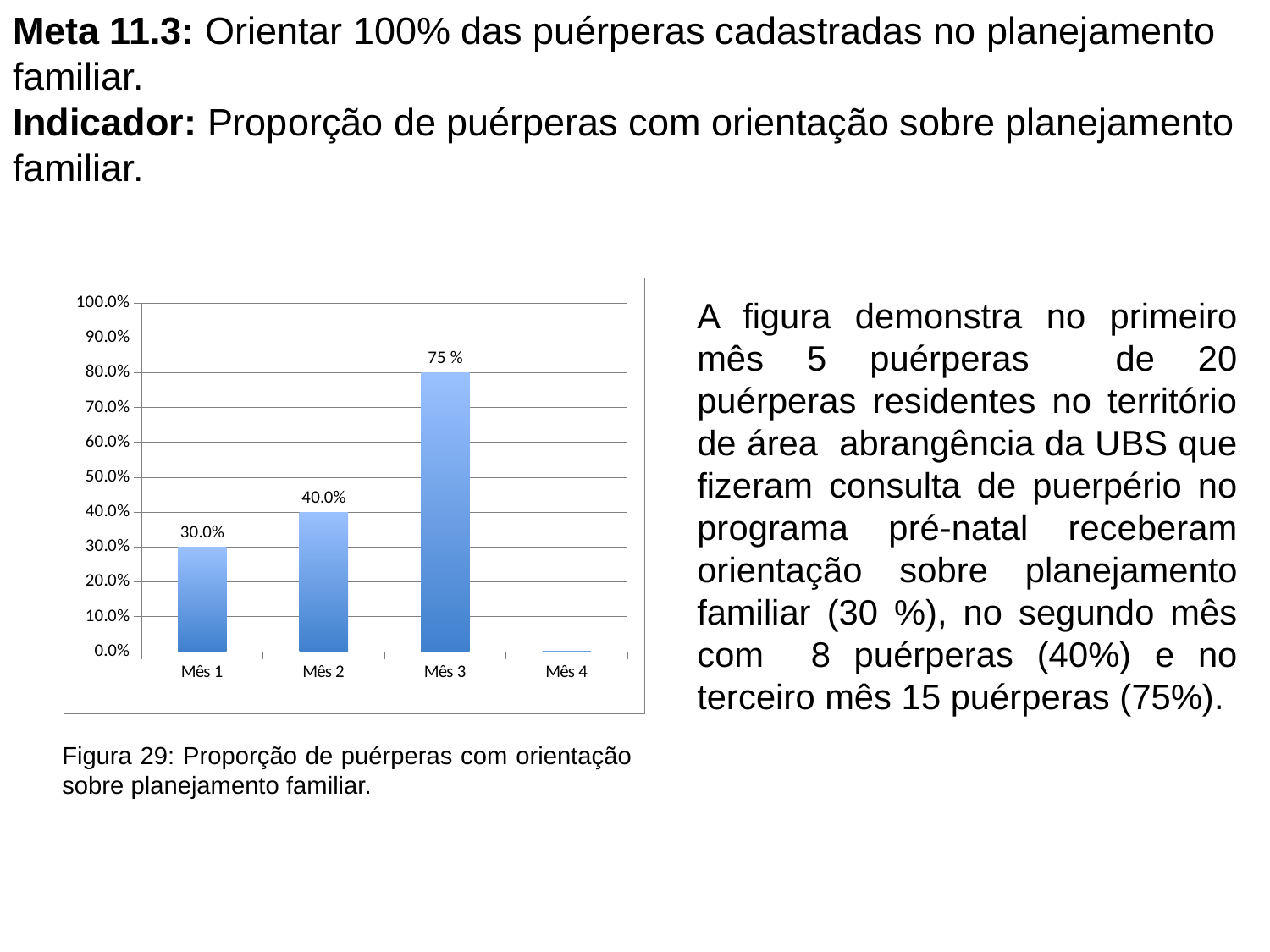
What is the highest value shown on the y axis of the chart? 100.0% What is the difference between the values for Mês 2 and Mês 1? 10.0% Do the values rise or fall from Mês 1 to Mês 3? Rise What is the value shown for Mês 2? 40.0% Is the value for Mês 3 greater or less than 60.0%? greater Which month has the highest value in the chart? Mês 3 What is the value shown for Mês 1? 30.0% What type of chart is shown on the slide? Bar chart Which month has the lowest value in the chart? Mês 4 What data label is printed above the bar for Mês 3? 75 % How many month categories are shown on the x axis? 4 Which is larger, the value for Mês 1 or the value for Mês 2? Mês 2